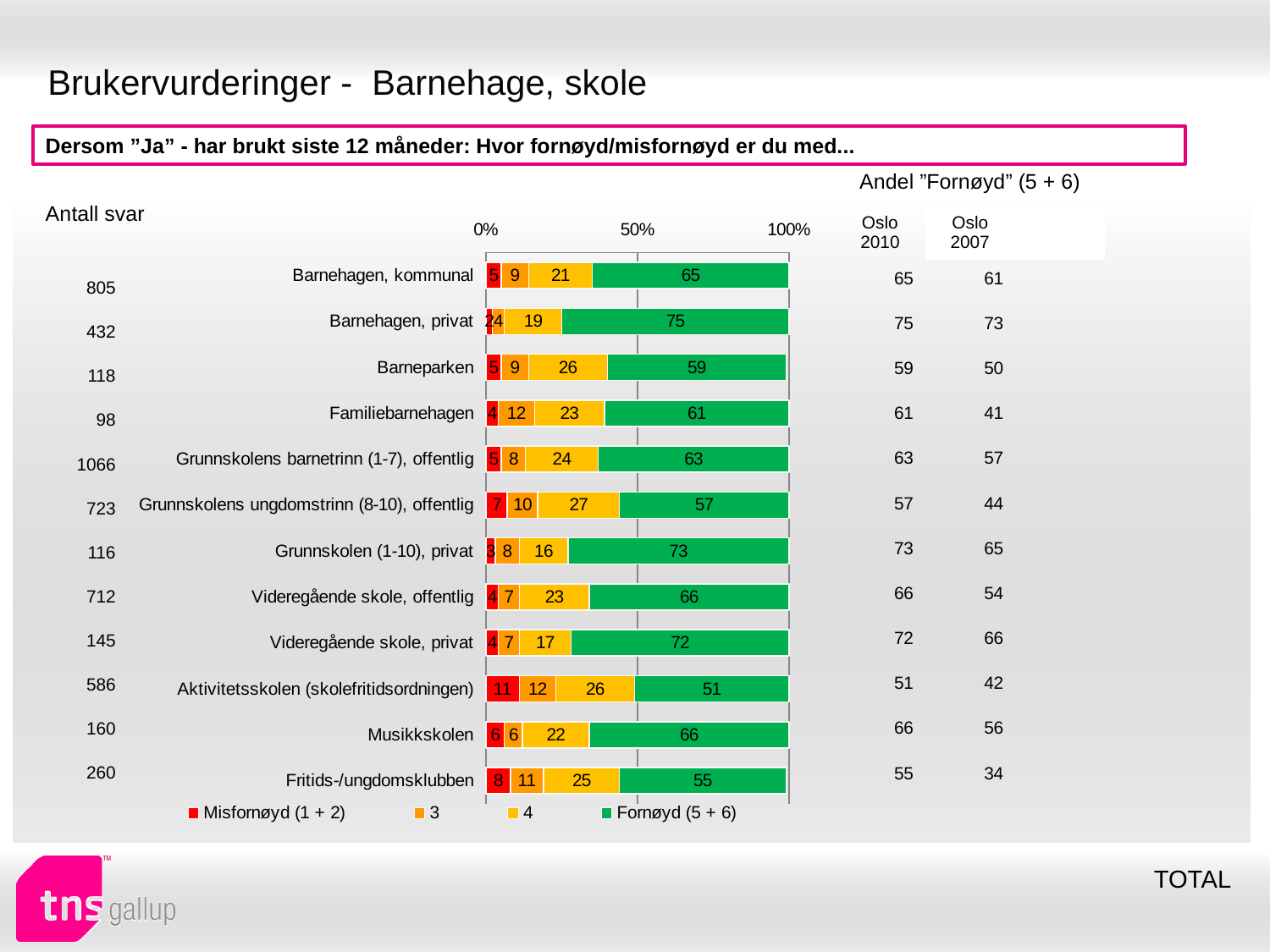
What is the difference between the Fornøyd (5 + 6) values for Barnehagen, privat and Barnehagen, kommunal? 10 What kind of chart is shown on the slide? Stacked bar chart Which category has the highest Misfornøyd (1 + 2) value? Aktivitetsskolen (skolefritidsordningen) How many categories are shown in the chart? 12 What is the value of the '4' segment for Grunnskolens ungdomstrinn (8-10), offentlig? 27 Which category has the lowest Fornøyd (5 + 6) value? Aktivitetsskolen (skolefritidsordningen) How many series does the legend list? 4 What is the value of the Fornøyd (5 + 6) segment for Barnehagen, privat? 75 Which has a larger Fornøyd (5 + 6) value, Barneparken or Familiebarnehagen? Familiebarnehagen Is the Fornøyd (5 + 6) value for Barnehagen, privat greater or less than 50%? greater What is the value of the '3' segment for Familiebarnehagen? 12 Which category has the highest Fornøyd (5 + 6) value? Barnehagen, privat